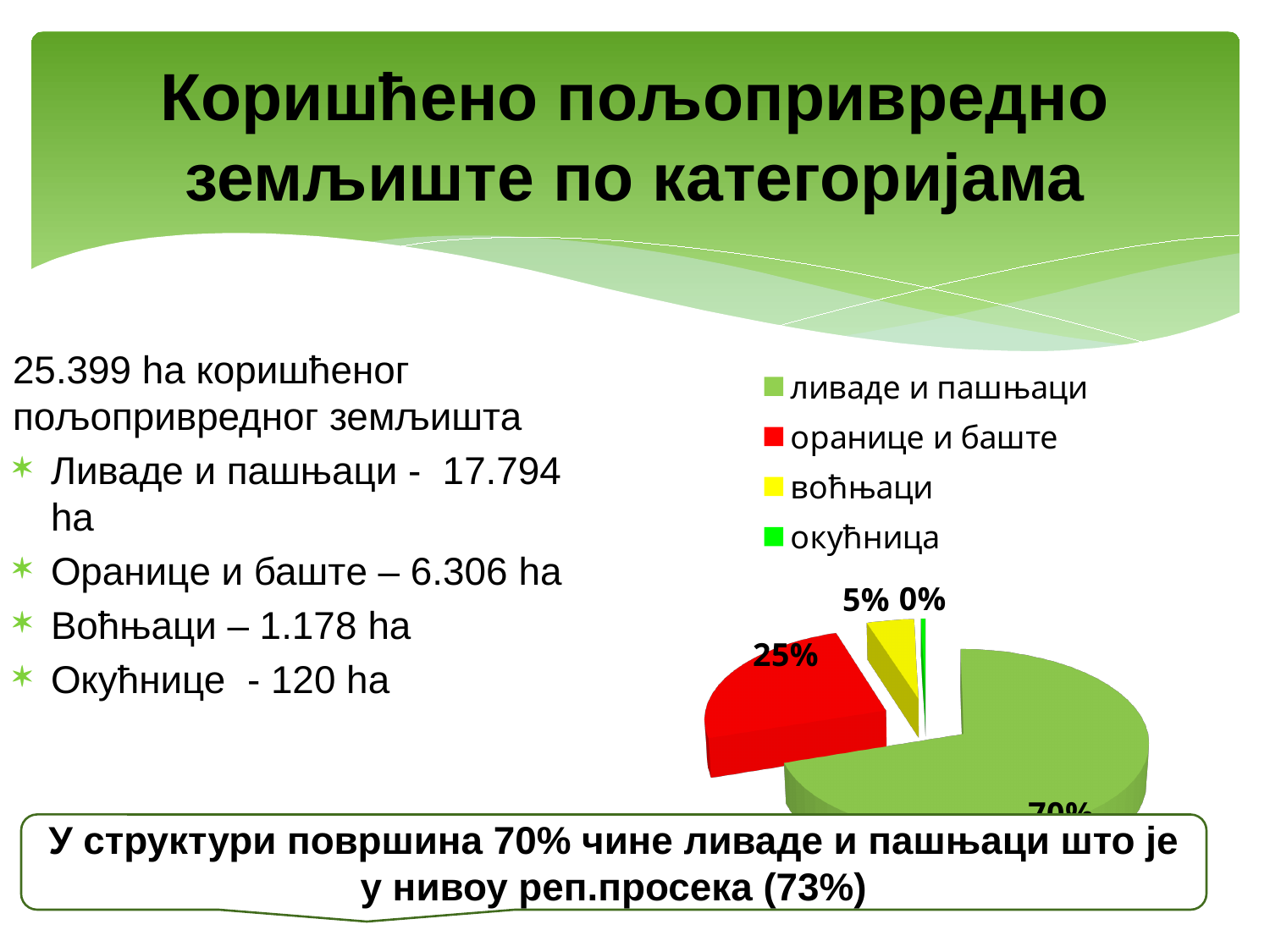
What colour is the воћњаци slice in the pie chart? yellow How many categories does the legend of the pie chart list? 4 What share of the pie does ливаде и пашњаци have? 70% What percentage is shown for воћњаци in the pie chart? 5% What kind of chart is shown on the slide? pie chart What is the difference in percentage points between the оранице и баште slice and the воћњаци slice? 20% What share of the pie does оранице и баште have? 25% Which category has the smallest slice of the pie chart? окућница Which slice is larger, оранице и баште or воћњаци? оранице и баште What colour is the оранице и баште slice in the pie chart? red Which category has the largest slice of the pie chart? ливаде и пашњаци What percentage is shown for окућница in the pie chart? 0%